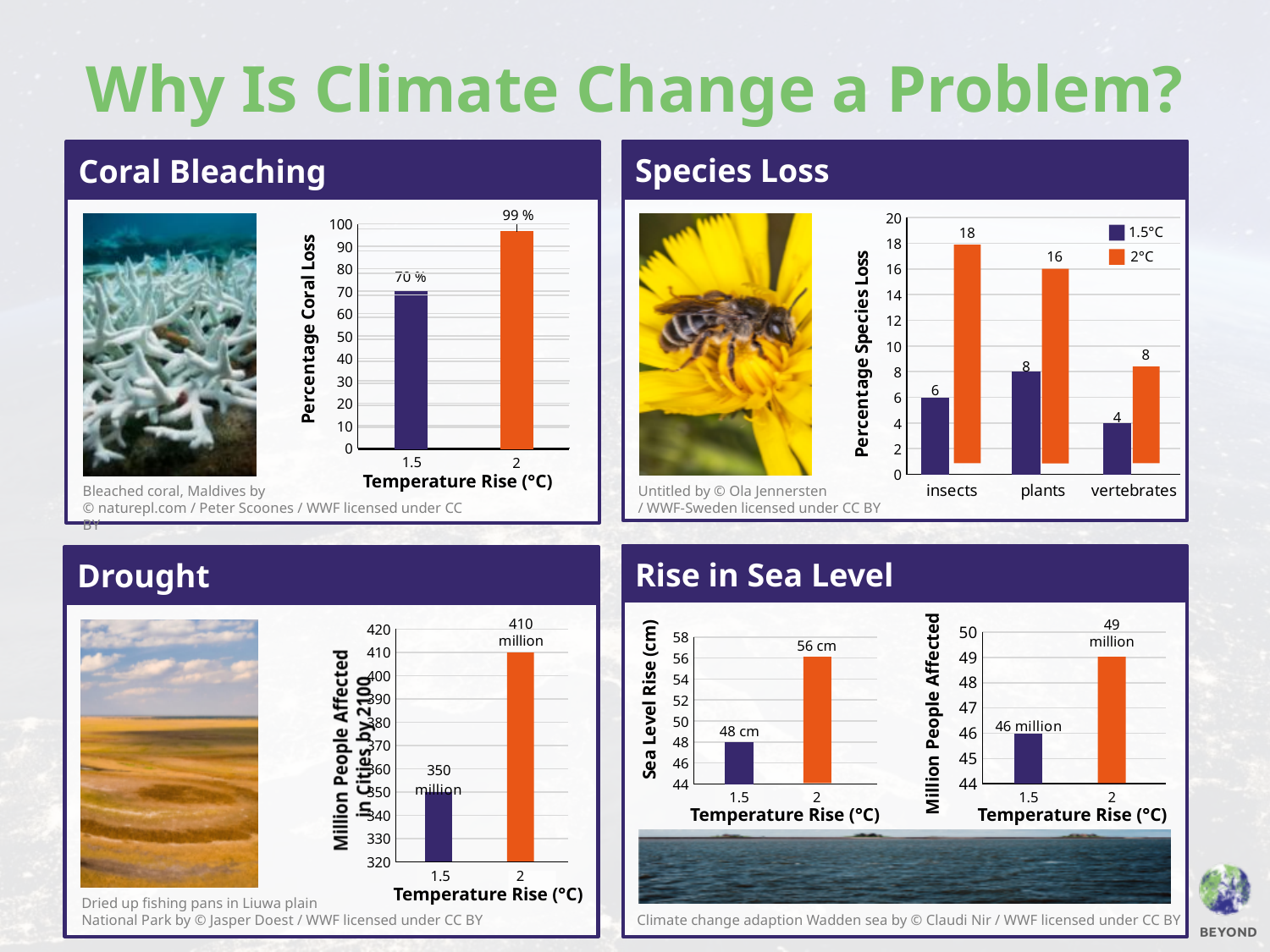
In the Drought chart, how many million people are affected in cities by 2100 at a 2°C temperature rise? 410 million In the Drought chart, what is the difference in million people affected between a 2°C and a 1.5°C temperature rise? 60 million In the Coral Bleaching chart, what is the percentage coral loss at a 1.5°C temperature rise? 70 % In the Species Loss chart, which category has the lowest percentage species loss at 1.5°C? vertebrates In the Coral Bleaching chart, what is the percentage coral loss at a 2°C temperature rise? 99 % In the Rise in Sea Level section, what is the difference in million people affected between a 2°C and a 1.5°C temperature rise in the right chart? 3 million In the Coral Bleaching chart, what is the difference in percentage coral loss between a 2°C and a 1.5°C temperature rise? 29 % In the Rise in Sea Level section, what is the sea level rise at a 1.5°C temperature rise in the left chart? 48 cm In the Species Loss chart, what is the percentage species loss for insects at 2°C? 18 How many series does the legend of the Species Loss chart list? 2 How many categories are shown on the x axis of the Species Loss chart? 3